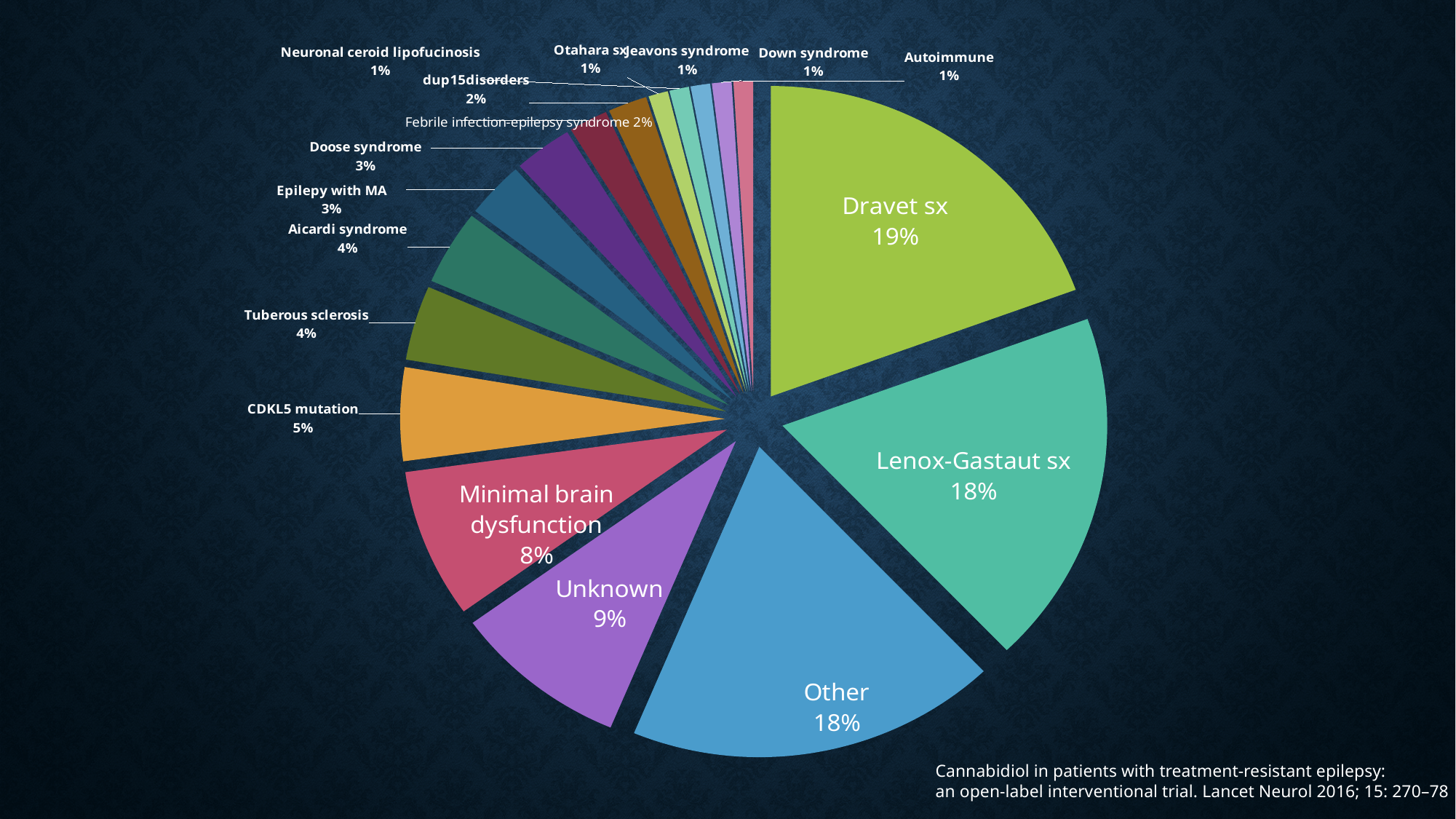
What is the difference between the Dravet sx share and the Unknown share? 10% What is the value shown for Lenox-Gastaut sx? 18% Which category has the largest slice of the pie? Dravet sx What is the value shown for Tuberous sclerosis? 4% What type of chart is shown on the slide? pie chart What share of the pie does Dravet sx represent? 19% What is the value shown for CDKL5 mutation? 5% How many categories are shown in the pie chart? 17 What is the value shown for Minimal brain dysfunction? 8% Which is larger, the share for Minimal brain dysfunction or the share for CDKL5 mutation? Minimal brain dysfunction What is the value shown for Unknown? 9% What is the value shown for Doose syndrome? 3%